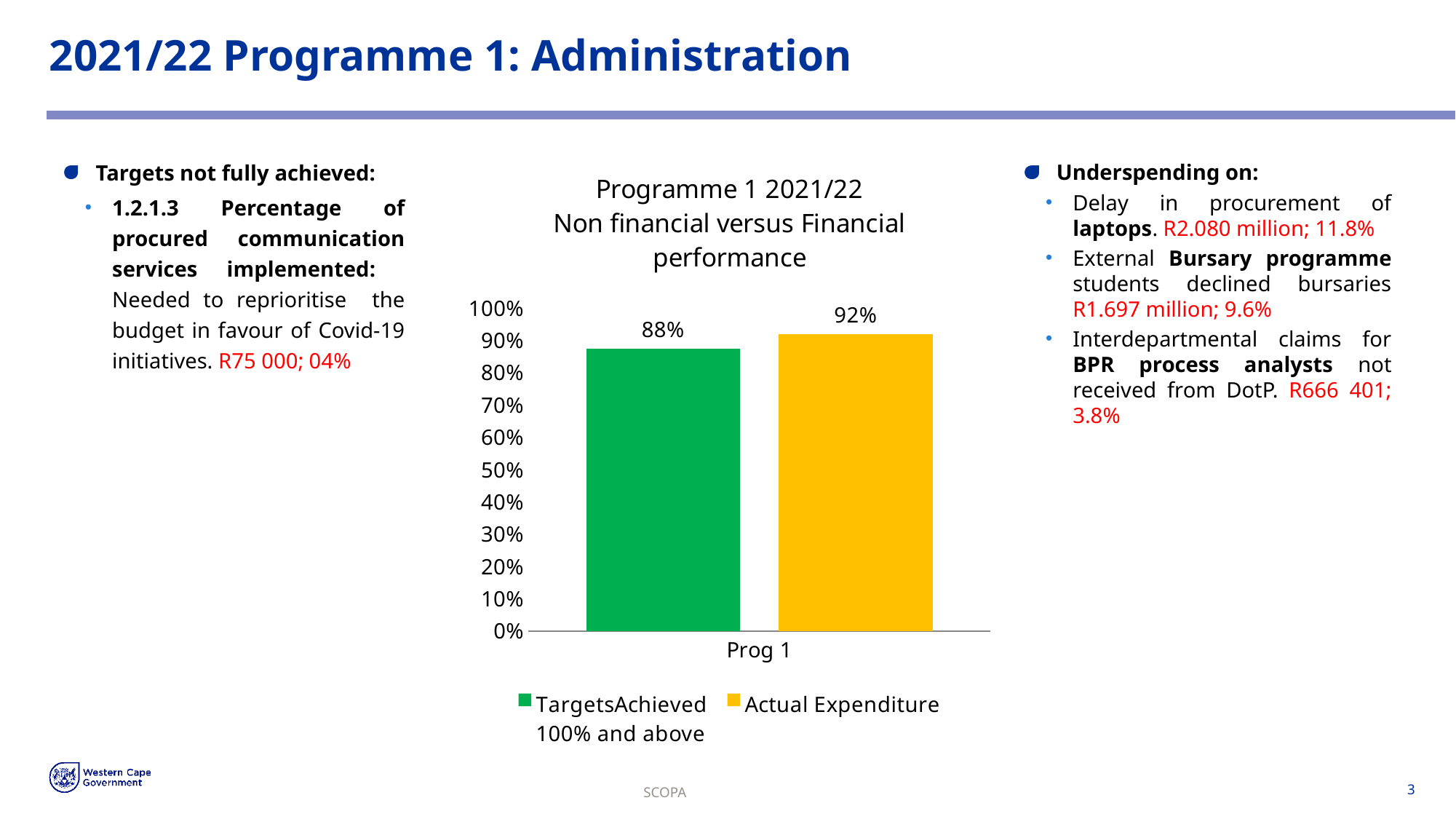
Which series has the higher value for Prog 1, Targets Achieved 100% and above or Actual Expenditure? Actual Expenditure What is the value of Targets Achieved 100% and above for Prog 1? 88% What is the title of the chart? Programme 1 2021/22 Non financial versus Financial performance What is the label of the category on the x axis? Prog 1 What is the difference between Actual Expenditure and Targets Achieved 100% and above for Prog 1? 4% Which colour represents Actual Expenditure in the chart? Yellow How many series does the legend list? 2 Is the value for Actual Expenditure greater or less than 90%? greater Is the value for Targets Achieved 100% and above greater or less than 90%? less What is the value of Actual Expenditure for Prog 1? 92% How many categories are shown on the x axis? 1 What kind of chart is shown on the slide? Bar chart